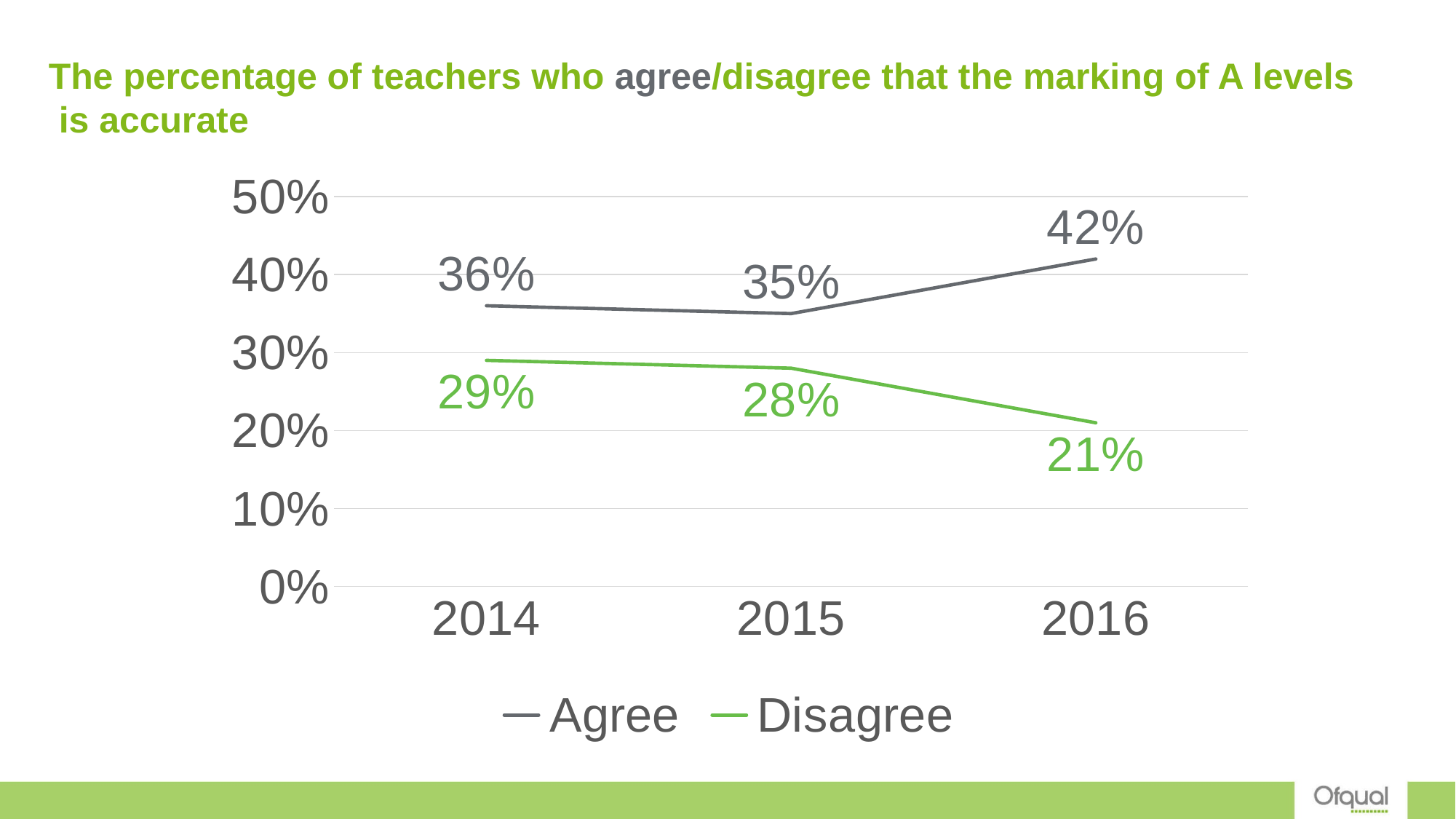
What percentage of teachers disagreed that the marking of A levels is accurate in 2014? 29% In which year was the Agree percentage highest? 2016 In which year was the Disagree percentage lowest? 2016 By how many percentage points did the Disagree value fall from 2014 to 2016? 8 percentage points Which series has the larger value in 2014, Agree or Disagree? Agree What is the value for the Agree series in 2015? 35% What percentage of teachers agreed that the marking of A levels is accurate in 2016? 42% How many series does the legend list? 2 How many years are shown on the x axis? 3 What kind of chart is shown on the slide? Line chart Does the Disagree series rise or fall from 2014 to 2016? Fall What is the difference between the Agree and Disagree percentages in 2016? 21%